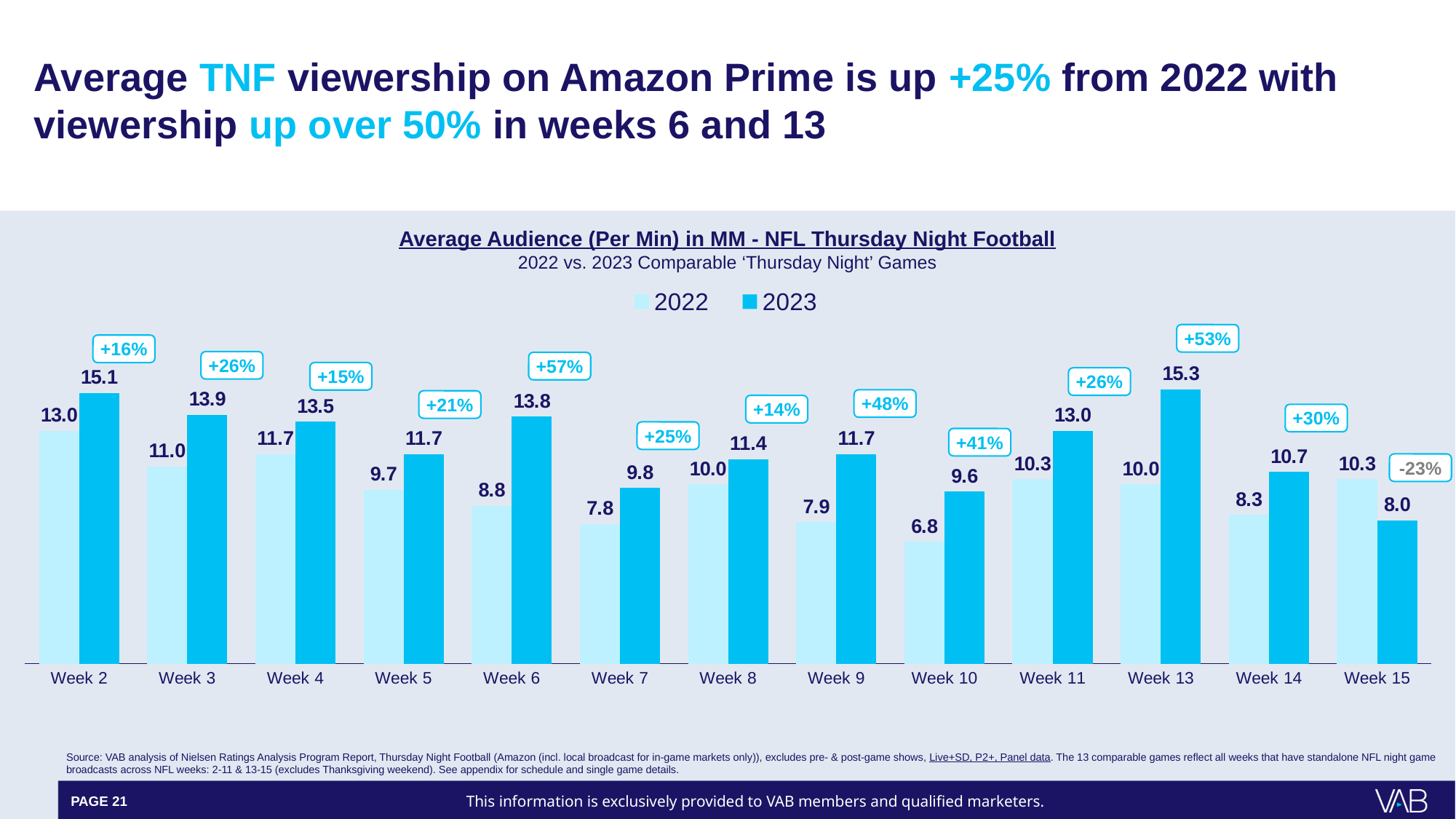
How many series does the legend list? 2 What is the title of the chart? Average Audience (Per Min) in MM - NFL Thursday Night Football What is the difference between the 2023 and 2022 average audience for Week 6? 5.0 What percentage change is labelled above Week 9? +48% How many weeks are shown on the x axis? 13 What is the 2023 average audience for Week 6? 13.8 Which week has the highest 2023 average audience? Week 13 What is the 2022 average audience for Week 10? 6.8 Which is larger for Week 15: the 2022 value or the 2023 value? 2022 What kind of chart is shown on the slide? Bar chart Which week has the lowest 2022 average audience? Week 10 What is the 2023 average audience for Week 13? 15.3